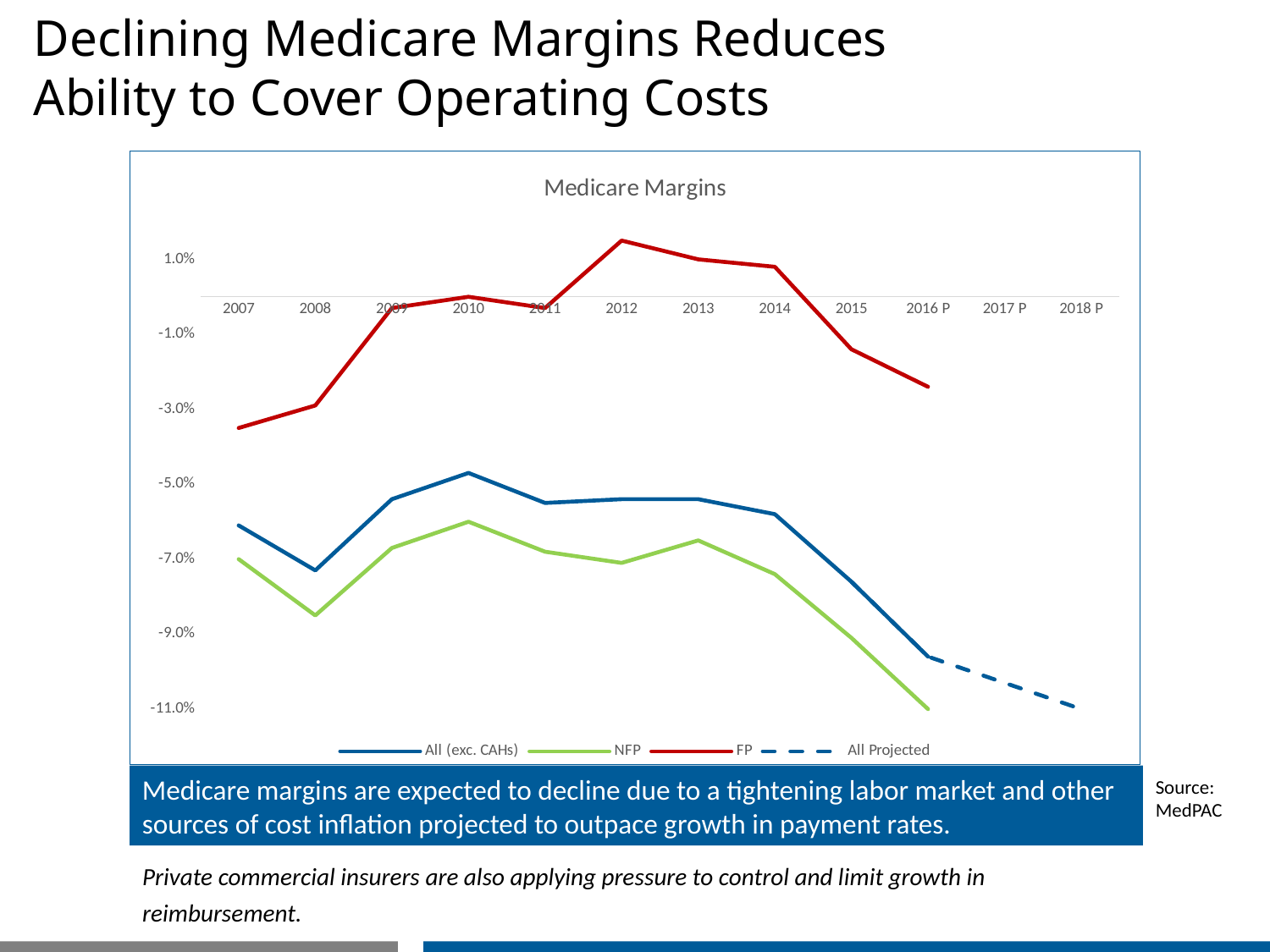
In which year does the FP series reach its highest value? 2012 What is the title of the chart? Medicare Margins In which year does the NFP series reach its lowest value? 2016 P How many years are labeled along the x axis of the chart? 12 How many series does the chart legend list? 4 Does the All Projected series rise or fall from 2016 P to 2018 P? Fall Is the All (exc. CAHs) value for 2016 P greater or less than -9.0%? less What kind of chart is shown on the slide? Line chart In 2015, which series has the higher value, All (exc. CAHs) or NFP? All (exc. CAHs) Is the NFP value for 2008 greater or less than -7.0%? less In which year does the All (exc. CAHs) series reach its highest value? 2010 Is the FP value for 2012 greater or less than 1.0%? greater